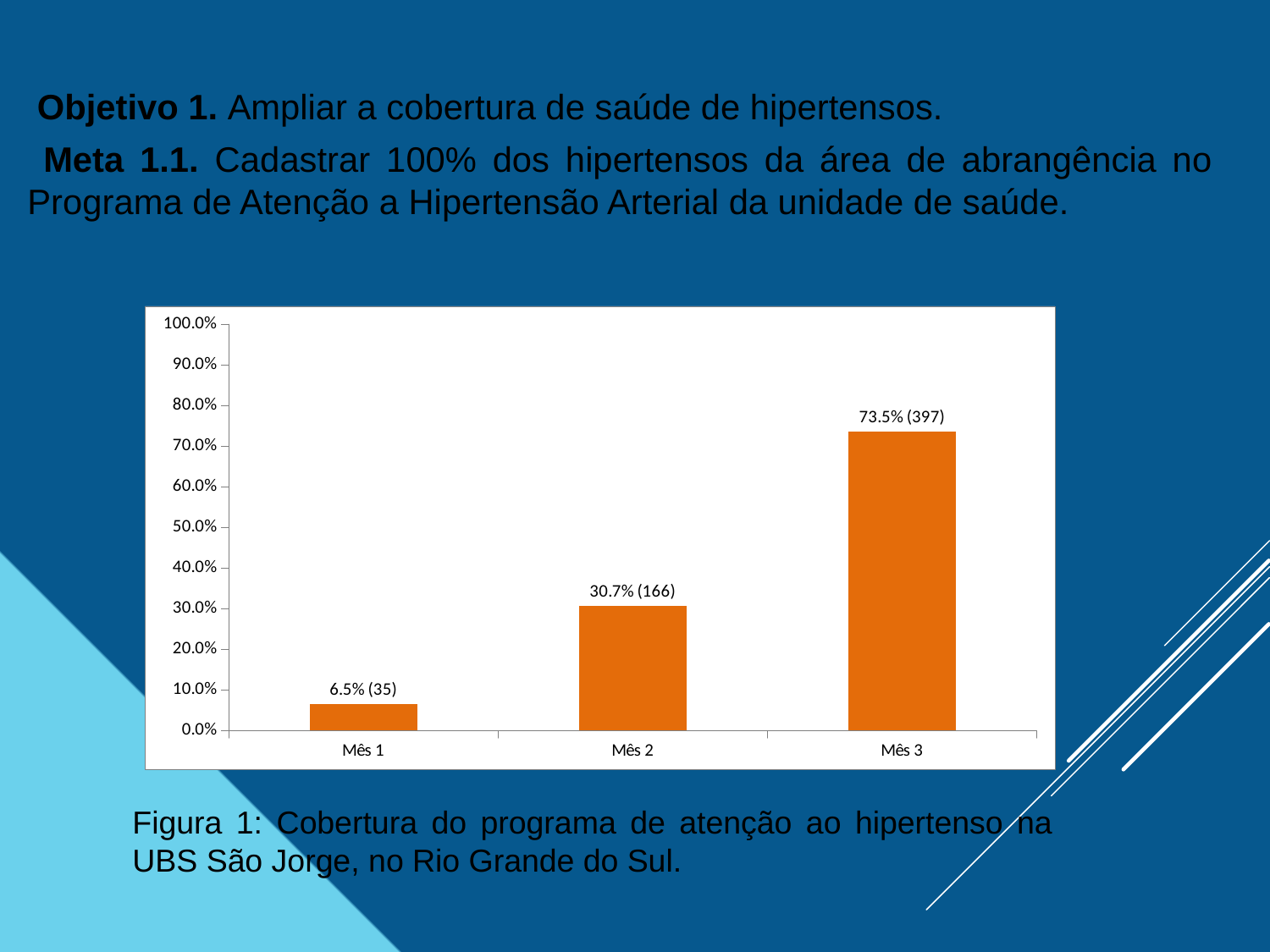
Which month has the highest coverage? Mês 3 Do the values rise or fall from Mês 1 to Mês 3? rise Is the value for Mês 3 greater or less than 70.0%? greater Which month has the lowest coverage? Mês 1 Which is larger, the coverage for Mês 1 or for Mês 2? Mês 2 How many more hypertensive patients were registered in Mês 2 than in Mês 1? 131 What is the difference in percentage points between Mês 3 and Mês 2? 42.8 How many months are shown on the x axis? 3 What is the coverage value shown for Mês 1? 6.5% (35) What is the coverage value shown for Mês 3? 73.5% (397) What is the coverage value shown for Mês 2? 30.7% (166) What kind of chart is shown on the slide? bar chart